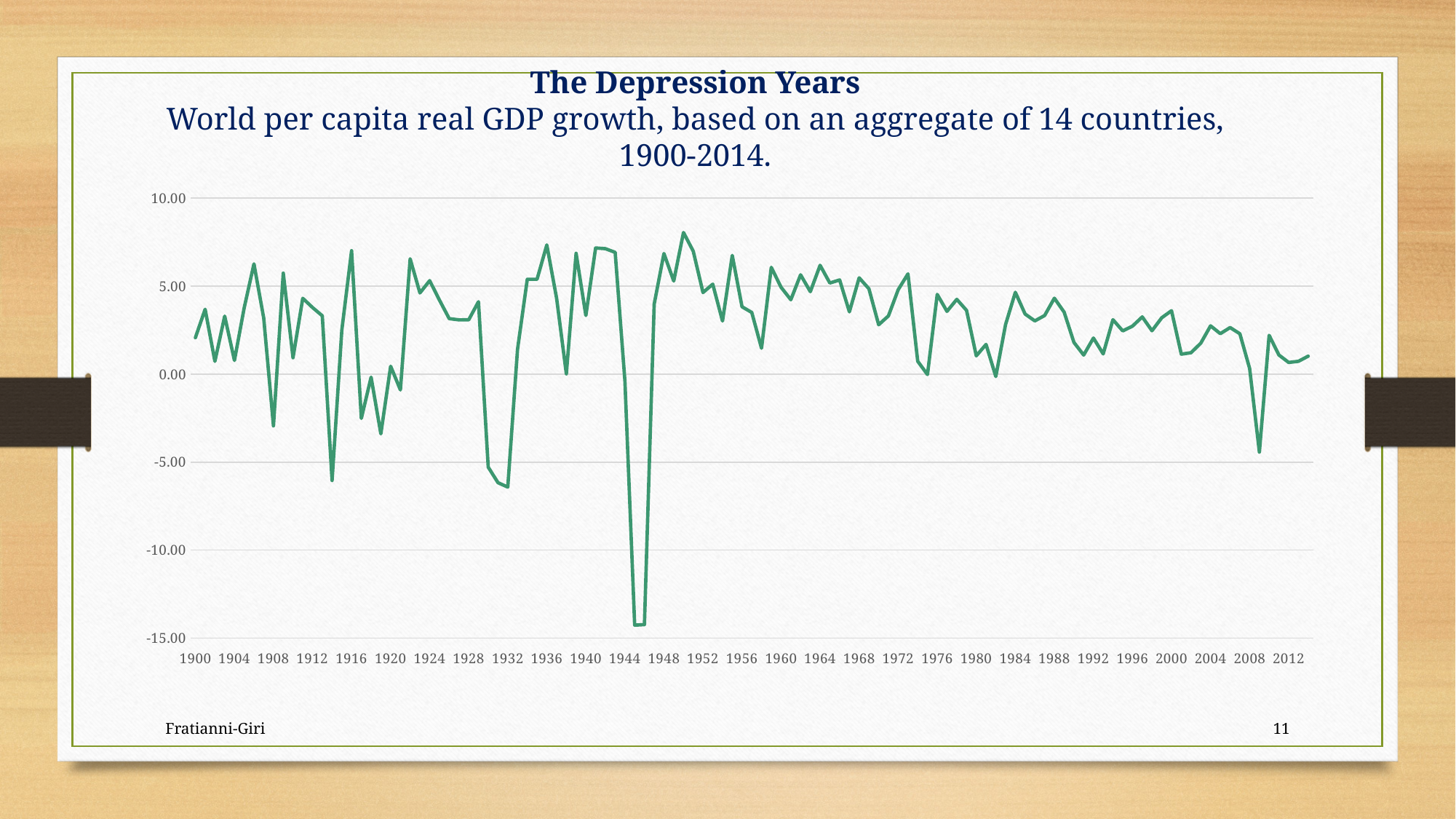
What is the last year labelled on the x axis? 2012 What is the first year shown on the x axis? 1900 Is the lowest point on the line greater or less than -10.00? less Is the value for 1936 greater or less than 5.00? greater What kind of chart is shown on the slide? line chart Is the value for 1932 greater or less than -5.00? less What colour is the line on the chart? green How many data series (lines) are plotted on the chart? 1 What is the highest value shown on the y axis? 10.00 What is the title of the chart on the slide? The Depression Years: World per capita real GDP growth, based on an aggregate of 14 countries, 1900-2014. What is the lowest value shown on the y axis? -15.00